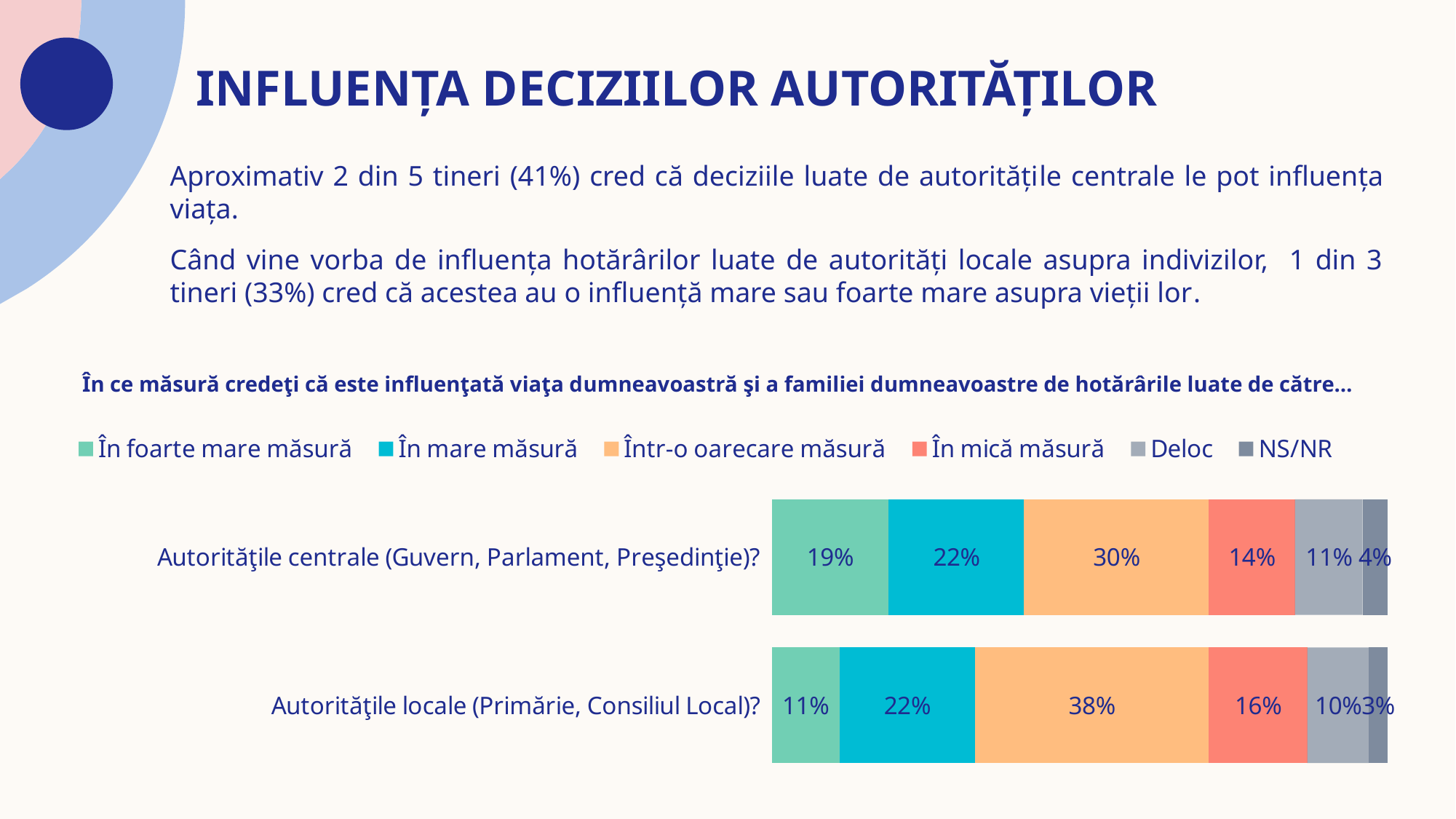
How many categories (bars) are plotted in the chart? 2 What is the value for "Deloc" for Autorităţile centrale (Guvern, Parlament, Preşedinţie)? 11% How many series does the legend list? 6 Which category has the larger value for "În mică măsură": Autorităţile centrale or Autorităţile locale? Autorităţile locale (Primărie, Consiliul Local) What kind of chart is shown on the slide? Stacked bar chart What colour represents "În mare măsură" in the legend? Teal/cyan What is the value for "Într-o oarecare măsură" for Autorităţile locale (Primărie, Consiliul Local)? 38% Which segment is the largest in the bar for Autorităţile locale (Primărie, Consiliul Local)? Într-o oarecare măsură Which segment is the smallest in the bar for Autorităţile centrale (Guvern, Parlament, Preşedinţie)? NS/NR What is the value for "În foarte mare măsură" for Autorităţile centrale (Guvern, Parlament, Preşedinţie)? 19% What is the value for "NS/NR" for Autorităţile locale (Primărie, Consiliul Local)? 3% What is the difference between the "În foarte mare măsură" values for Autorităţile centrale and Autorităţile locale? 8%